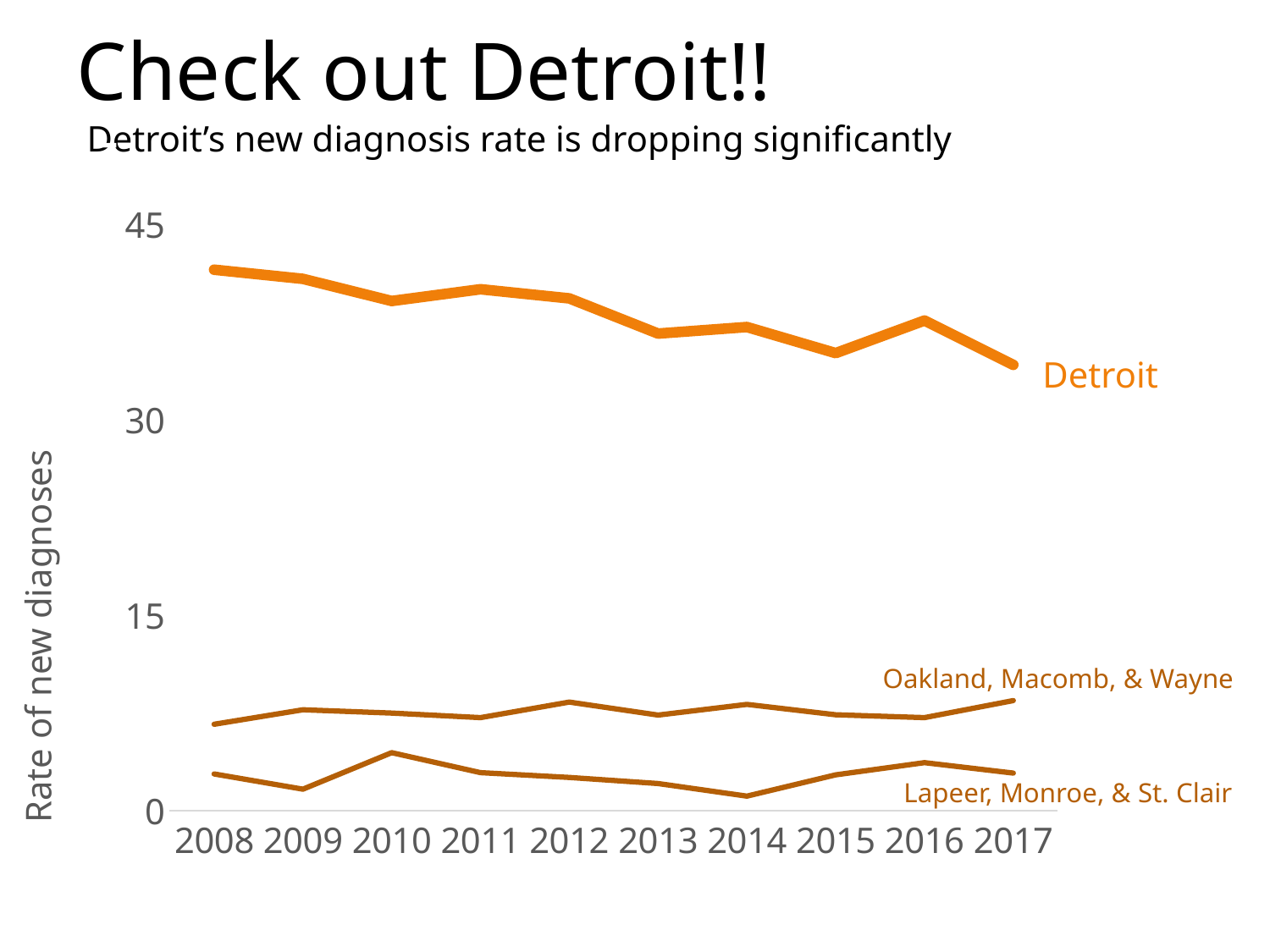
What kind of chart is shown on the slide? line chart Is the value for Detroit in 2017 greater or less than 30? greater Which series has the highest values across the chart? Detroit Which series has the lowest values across the chart? Lapeer, Monroe, & St. Clair Is the value for Oakland, Macomb, & Wayne in 2012 greater or less than 15? less In 2016, which is larger: the value for Oakland, Macomb, & Wayne or the value for Lapeer, Monroe, & St. Clair? Oakland, Macomb, & Wayne In 2010, which is larger: the value for Detroit or the value for Oakland, Macomb, & Wayne? Detroit Is the value for Detroit in 2008 greater or less than 30? greater How many series (lines) are plotted on the chart? 3 Does the Detroit line rise or fall from 2008 to 2017? fall How many years are shown along the x axis? 10 What is the label on the y axis of the chart? Rate of new diagnoses